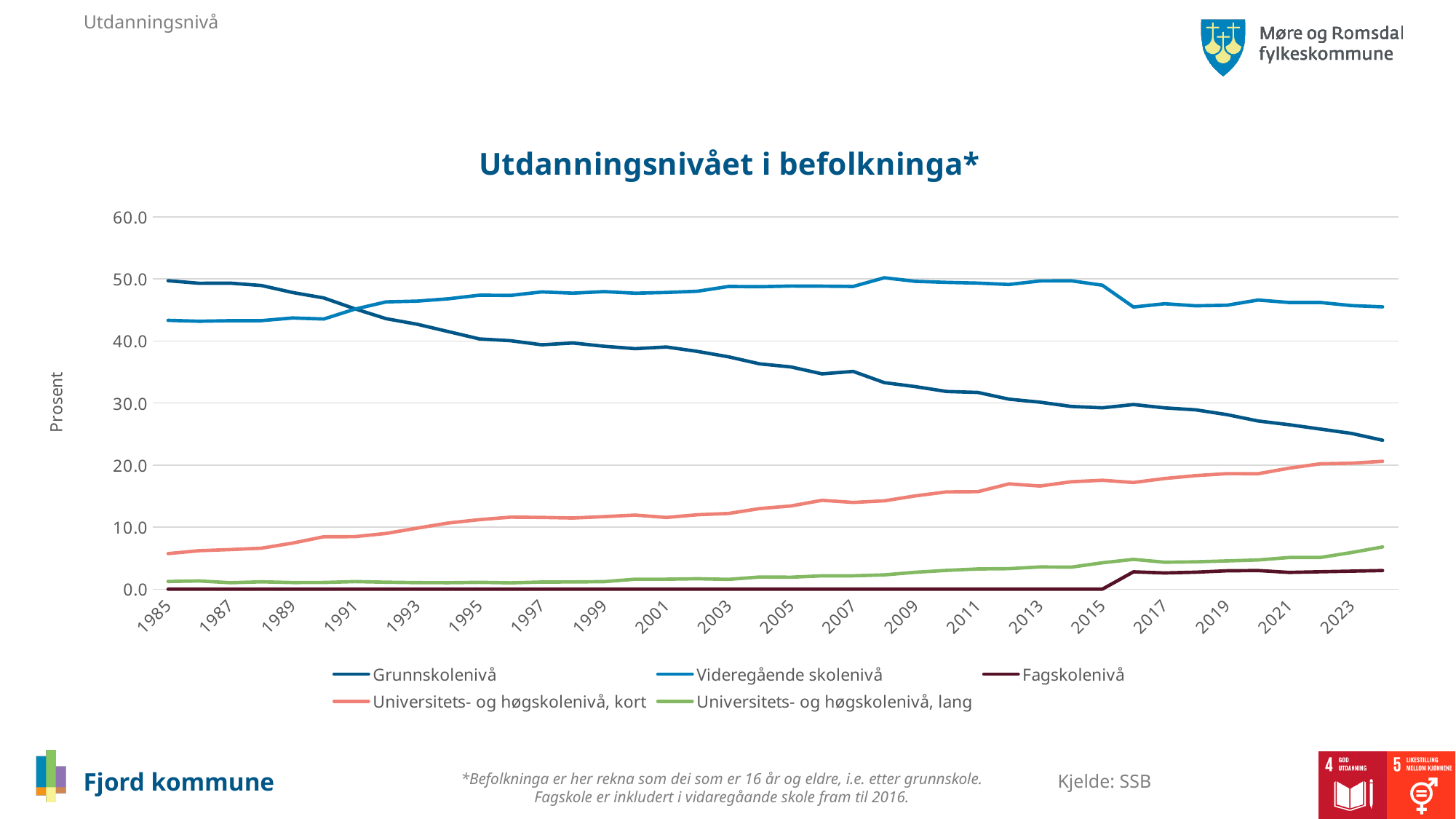
What is the title of the chart? Utdanningsnivået i befolkninga* In 2023, which is higher: Grunnskolenivå or Videregående skolenivå? Videregående skolenivå What kind of chart is shown on the slide? line chart Is the value for Grunnskolenivå in 1985 greater or less than 40.0? greater Does the Grunnskolenivå line rise or fall from 1985 to 2023? fall What is the label on the y axis? Prosent Which series has the lowest value in 2023? Fagskolenivå Is the value for Universitets- og høgskolenivå, lang in 2023 greater or less than 10.0? less In 1985, which is higher: Grunnskolenivå or Videregående skolenivå? Grunnskolenivå Which series has the highest value in 2023? Videregående skolenivå Does the Universitets- og høgskolenivå, kort line rise or fall from 1985 to 2023? rise How many series does the legend list? 5